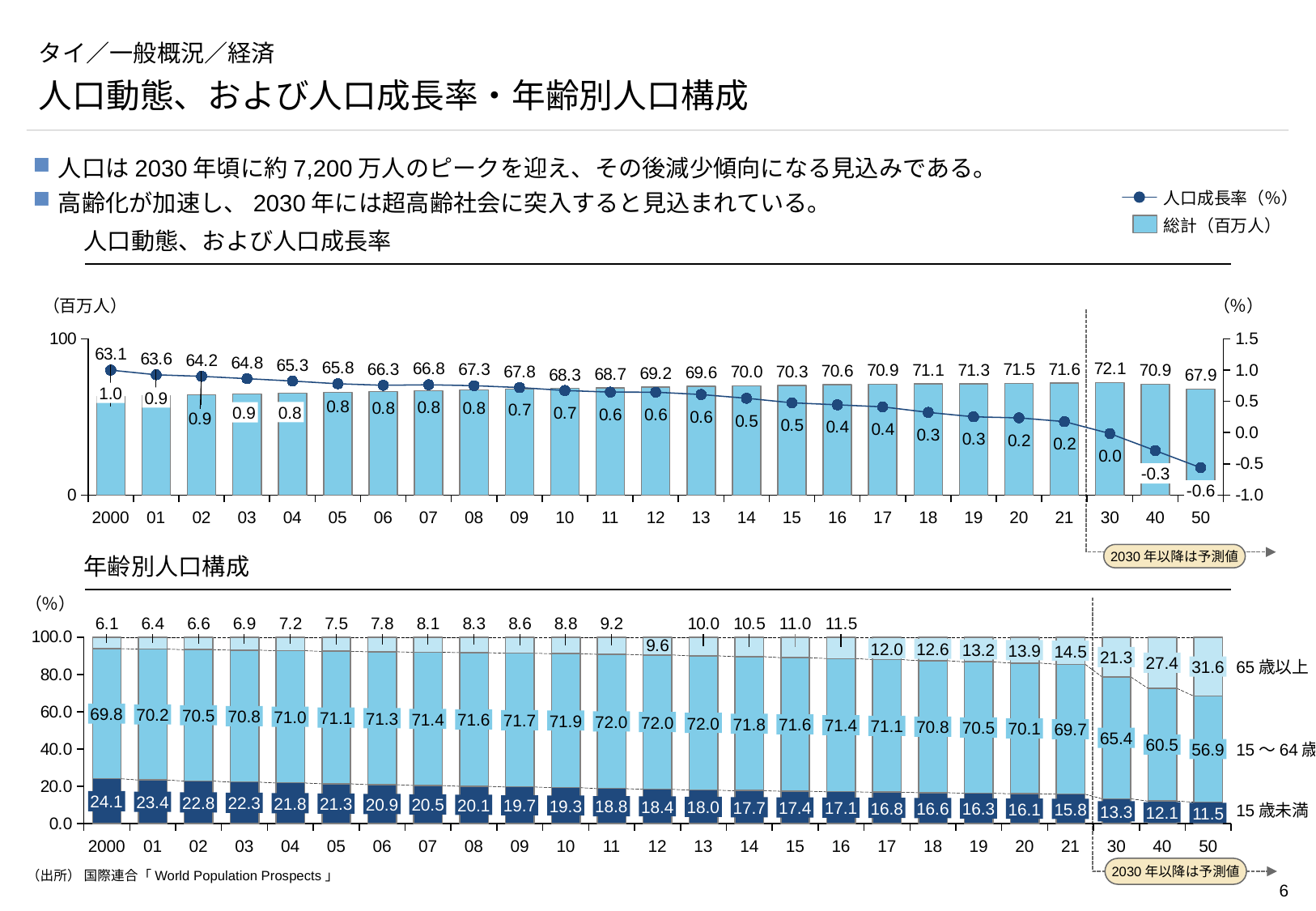
In the 年齢別人口構成 chart, what is the 65歳以上 share for 2050? 31.6 In the 年齢別人口構成 chart, how many years are shown on the x axis? 25 What kind of chart is the 年齢別人口構成 chart? stacked bar chart In the 年齢別人口構成 chart, which year has the lowest 15～64歳 share? 2050 In the 人口動態、および人口成長率 chart, what is the 総計 (百万人) value for 2030? 72.1 In the 人口動態、および人口成長率 chart, which year has the highest 総計 (百万人) value? 2030 In the 人口動態、および人口成長率 chart, what is the difference between the 総計 values for 2021 and 2000? 8.5 In the 年齢別人口構成 chart, what is the 15歳未満 share for 2000? 24.1 In the 人口動態、および人口成長率 chart, what is the 人口成長率 (%) value for 2050? -0.6 In the 人口動態、および人口成長率 chart, does the 人口成長率 line rise or fall from 2000 to 2050? fall In the 人口動態、および人口成長率 chart, how many series does the legend list? 2 In the 年齢別人口構成 chart, which is larger for 2040: the 65歳以上 share or the 15歳未満 share? 65歳以上